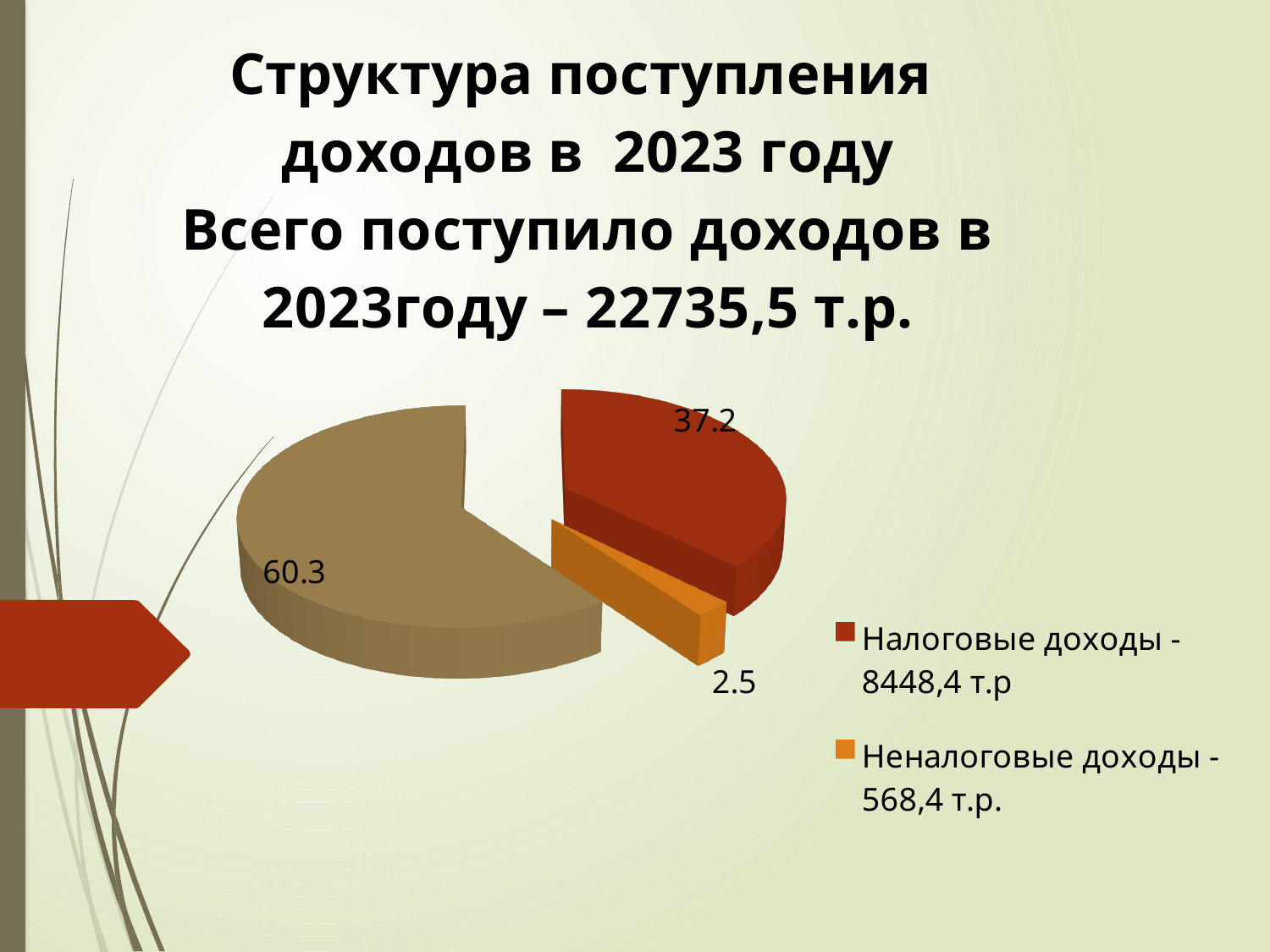
What value is labelled on the slice for Неналоговые доходы? 2.5 What value is labelled on the slice for Налоговые доходы? 37.2 How many slices does the pie chart have? 3 What is the value labelled on the largest slice of the pie? 60.3 Which legend category has the smallest slice of the pie? Неналоговые доходы What type of chart is shown on the slide? pie chart What amount is given in the legend for Неналоговые доходы? 568,4 т.р. What is the difference between the labelled values for Налоговые доходы and Неналоговые доходы? 34.7 How many entries does the legend list? 2 What colour is the slice for Налоговые доходы? red Which slice is larger: Налоговые доходы or Неналоговые доходы? Налоговые доходы